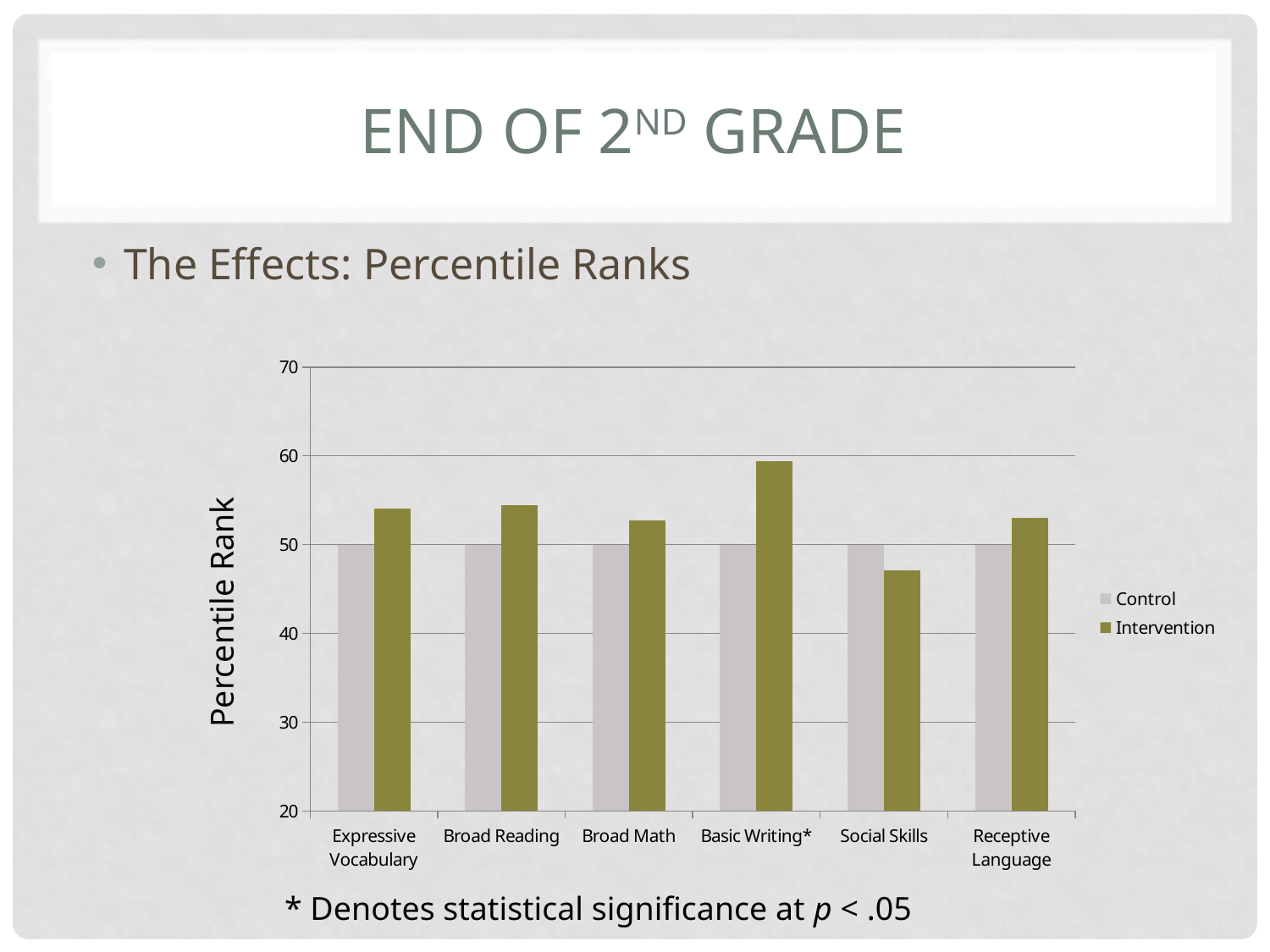
Is the Intervention value for Social Skills greater or less than 50? less Which category has the highest Intervention value? Basic Writing* Is the Intervention value for Basic Writing* greater or less than 50? greater What kind of chart is shown on the slide? bar chart Which is larger for Social Skills, the Control value or the Intervention value? Control Which category has the lowest Intervention value? Social Skills How many series does the legend list? 2 What is the Control value for Broad Reading? 50 What is the Control value for Social Skills? 50 What is the label on the y axis? Percentile Rank How many categories are shown on the x axis? 6